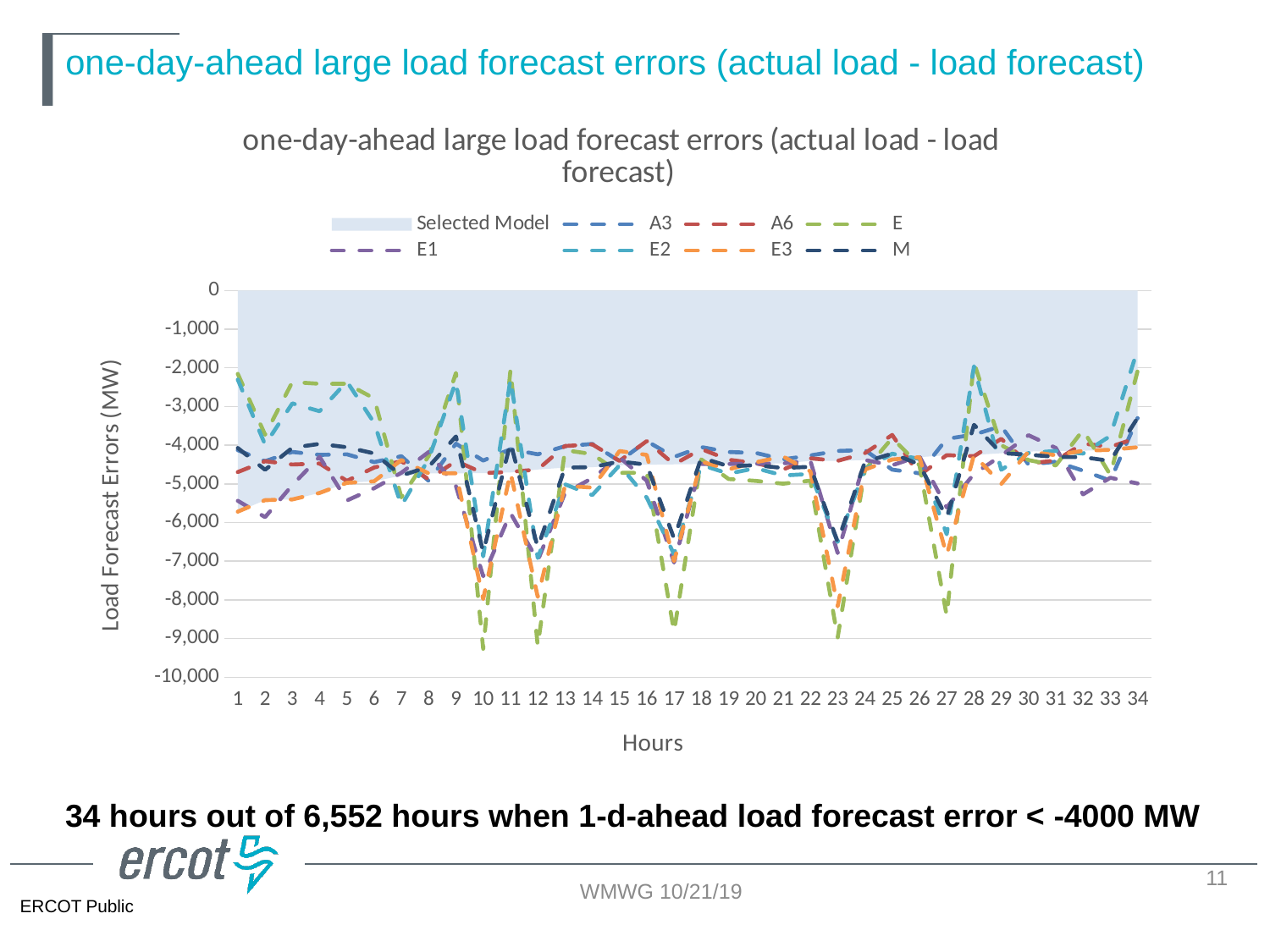
What kind of chart is shown on the slide? combination area and line chart Is the value for series E at hour 27 greater or less than -8,000? less Is the value for series E at hour 1 greater or less than -3,000? greater Which series reaches the lowest value on the chart? E Is the value for series E3 at hour 1 greater or less than -5,000? less Which legend entry is shown as a shaded area rather than a dashed line? Selected Model How many entries does the chart's legend list? 8 How many hours are plotted along the x axis of the chart? 34 What is the label of the chart's vertical axis? Load Forecast Errors (MW)